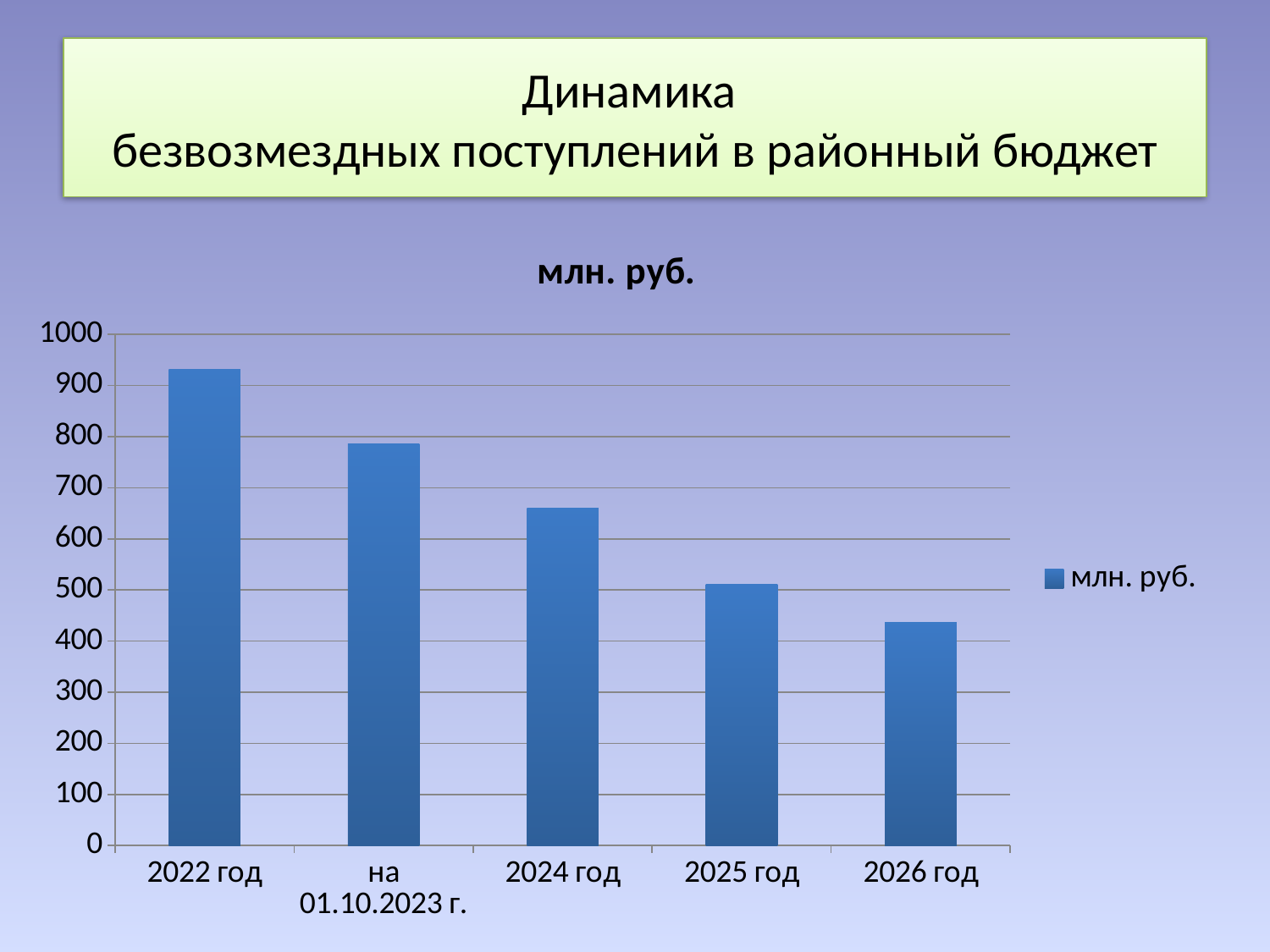
How many categories are shown on the x axis of the chart? 5 Is the value for 2022 год greater or less than 900? greater Which is larger, the value for 2024 год or the value for 2025 год? 2024 год What type of chart is shown on the slide? bar chart Which category has the highest value? 2022 год Which category has the lowest value? 2026 год Do the values rise or fall from 2022 год to 2026 год? fall Is the value for 2024 год greater or less than 600? greater How many series does the legend list? 1 Is the value for 2026 год greater or less than 500? less What is the title shown above the chart? млн. руб.